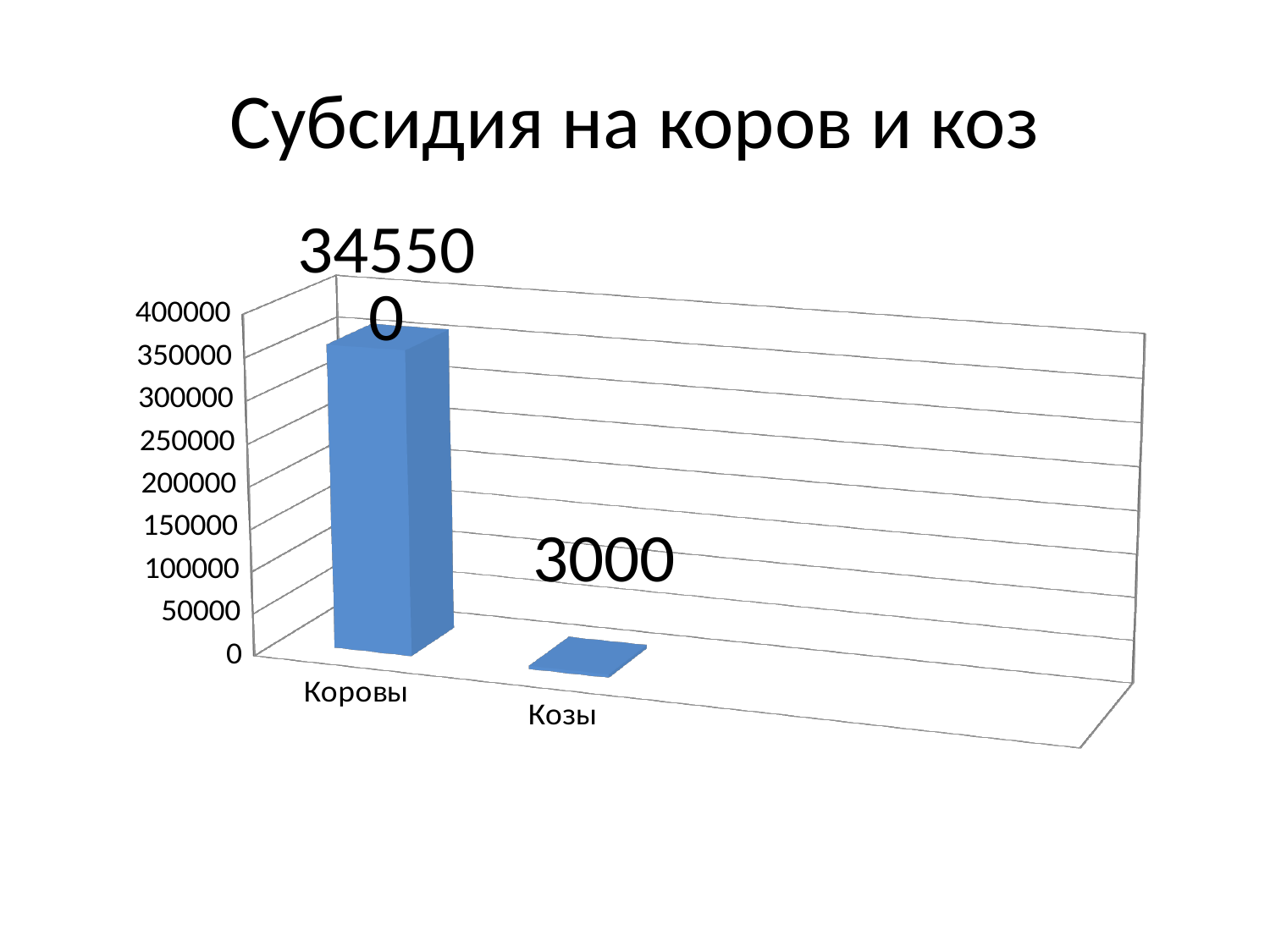
What is the highest value shown on the vertical axis? 400000 What is the value for Коровы? 345500 What is the value for Козы? 3000 Is the value for Коровы greater or less than 300000? greater How many categories are shown on the chart? 2 Is the value for Козы greater or less than 50000? less What is the difference between the values for Коровы and Козы? 342500 What kind of chart is shown on the slide? bar chart What is the title of the slide? Субсидия на коров и коз Which is larger, the value for Коровы or the value for Козы? Коровы Which category has the highest value? Коровы Which category has the lowest value? Козы